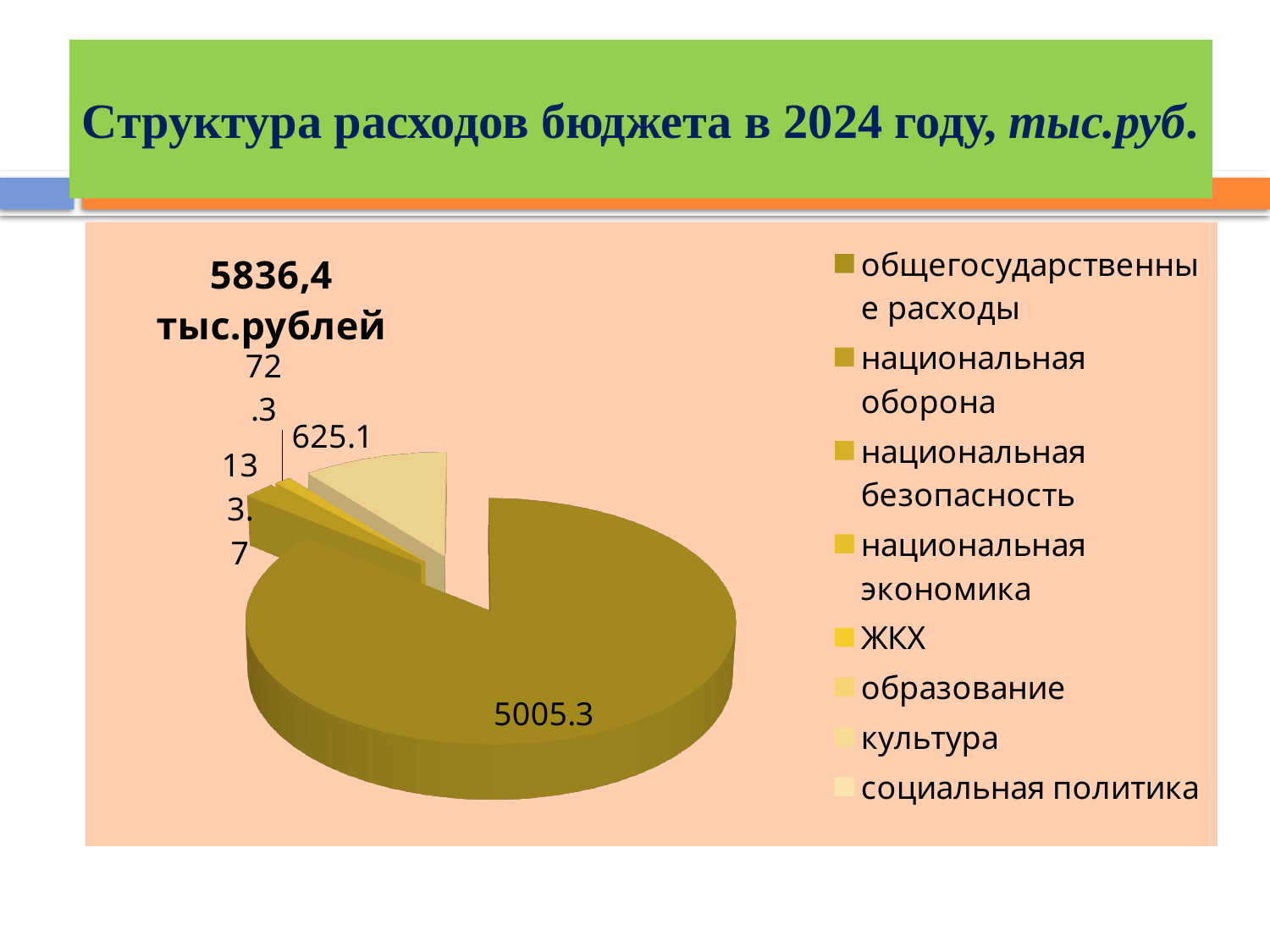
What share of the total 5836.4 does the largest slice (5005.3) represent? 85.8% How many entries does the legend list? 8 How many slices of the pie have a printed data label? 4 What total amount is printed above the pie chart? 5836,4 тыс.рублей Which category does the largest slice of the pie represent? общегосударственные расходы What is the title of the chart on the slide? 5836,4 тыс.рублей What is the value of the largest slice of the pie? 5005.3 Which is larger, the slice labelled 625.1 or the slice labelled 133.7? 625.1 What kind of chart is shown on the slide? pie chart What is the value for общегосударственные расходы? 5005.3 What is the smallest labelled value on the pie chart? 72.3 What is the difference between the largest slice (5005.3) and the slice labelled 625.1? 4380.2